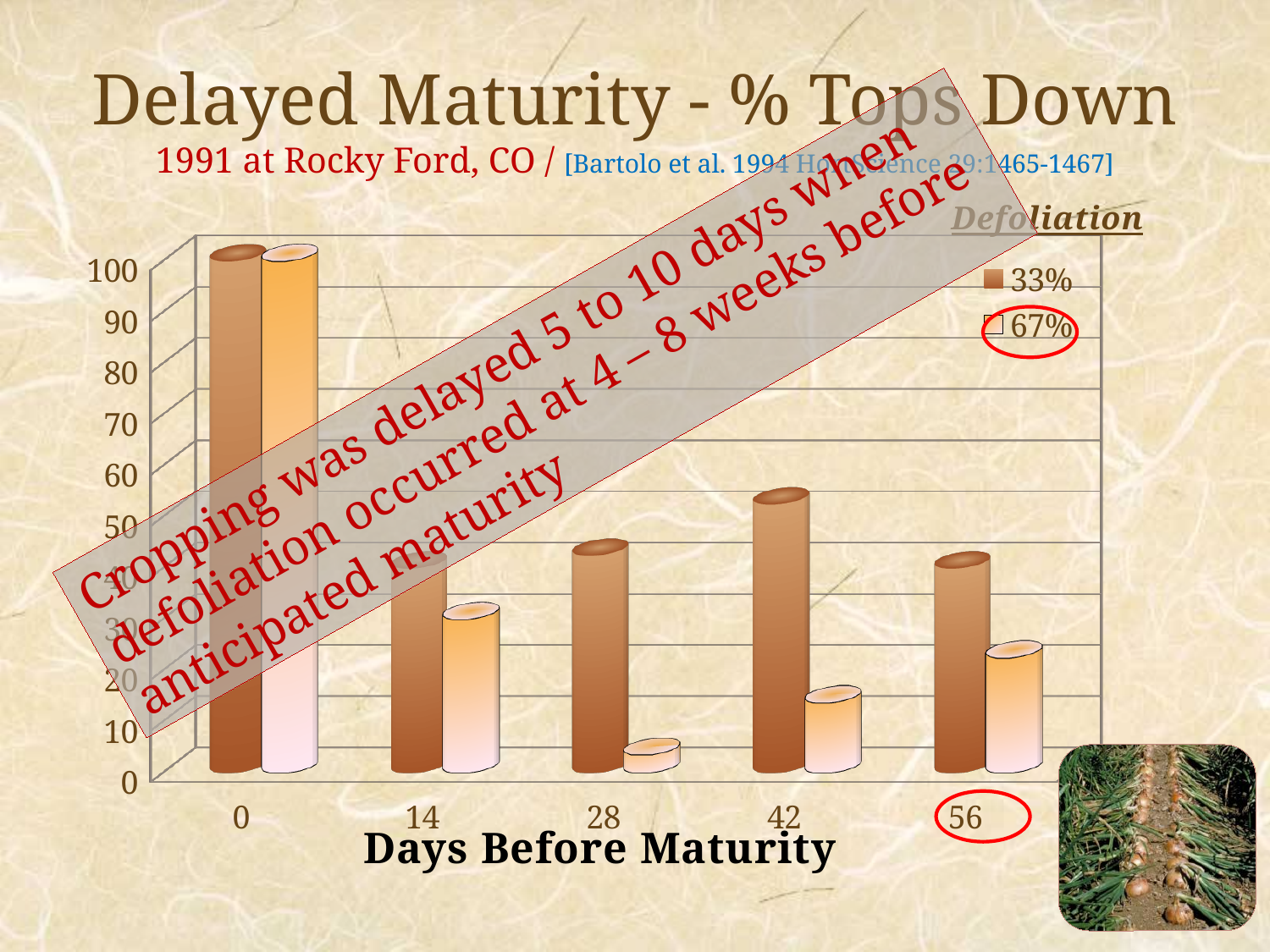
What kind of chart is shown on the slide? bar chart Is the value for the 67% series at 42 days before maturity greater or less than 30? less Is the value for the 67% series at 28 days before maturity greater or less than 10? less How many categories are shown on the x axis (Days Before Maturity)? 5 What are the two entries in the Defoliation legend? 33% and 67% At 28 days before maturity, which series has the larger value, 33% or 67%? 33% How many series does the legend list? 2 What is the title of the x axis? Days Before Maturity Is the value for the 33% series at 0 days before maturity greater or less than 90? greater For the 67% series, which days-before-maturity category has the lowest value? 28